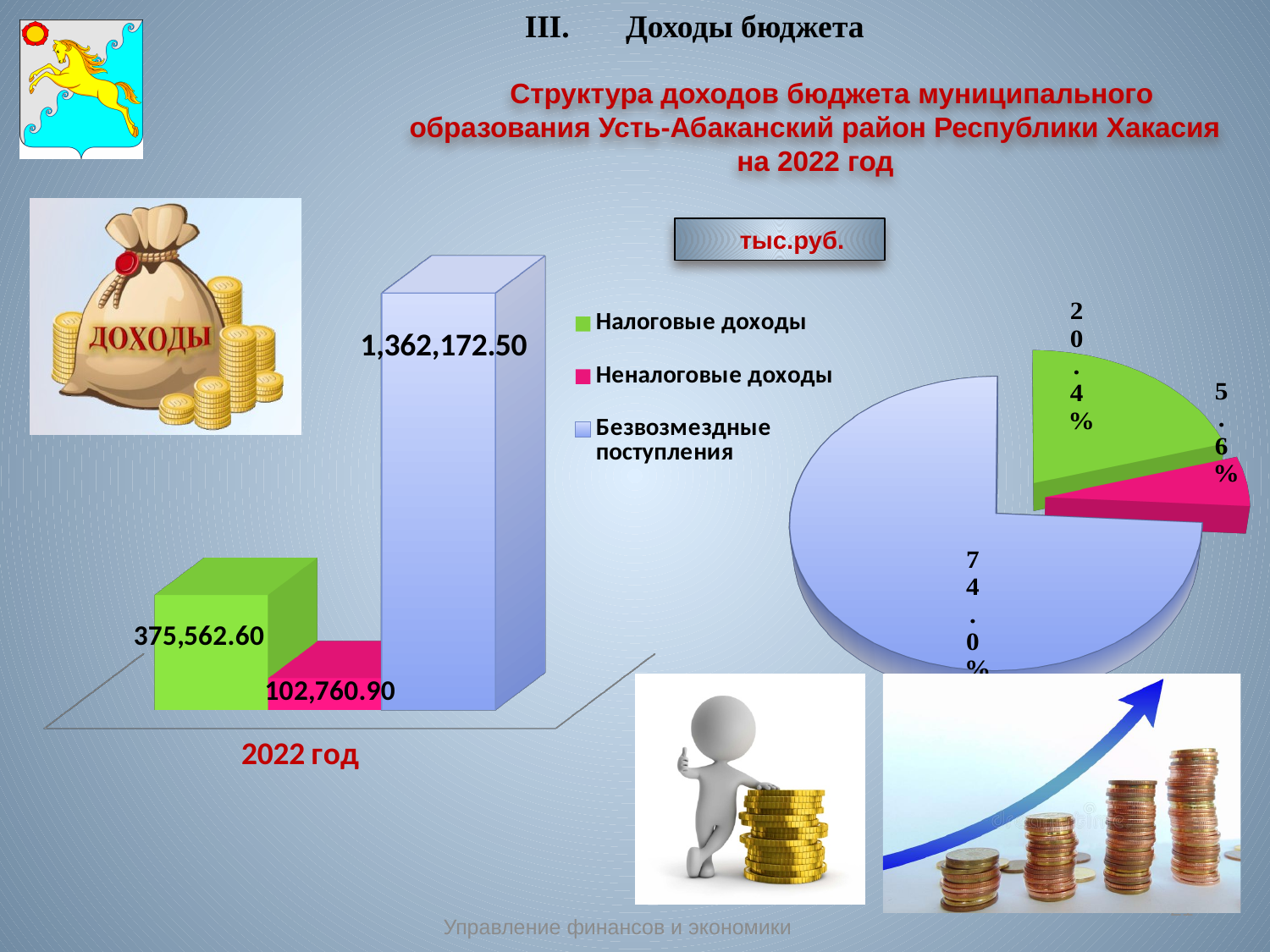
On the bar chart on the left, what is the value for Налоговые доходы in 2022? 375,562.60 On the pie chart on the right, what share does the blue slice (Безвозмездные поступления) have? 74.0% On the bar chart on the left, what is the value for Неналоговые доходы in 2022? 102,760.90 On the bar chart on the left, what is the value for Безвозмездные поступления in 2022? 1,362,172.50 How many entries does the legend list? 3 What kind of chart is shown on the left of the slide? Bar chart On the bar chart on the left, which is larger: Налоговые доходы or Безвозмездные поступления? Безвозмездные поступления On the bar chart on the left, which category has the lowest value? Неналоговые доходы On the bar chart on the left, which category has the highest value? Безвозмездные поступления On the bar chart on the left, what is the difference between Налоговые доходы and Неналоговые доходы? 272,801.70 On the bar chart on the left, how many bars are shown? 3 On the pie chart on the right, what share does the green slice (Налоговые доходы) have? 20.4%